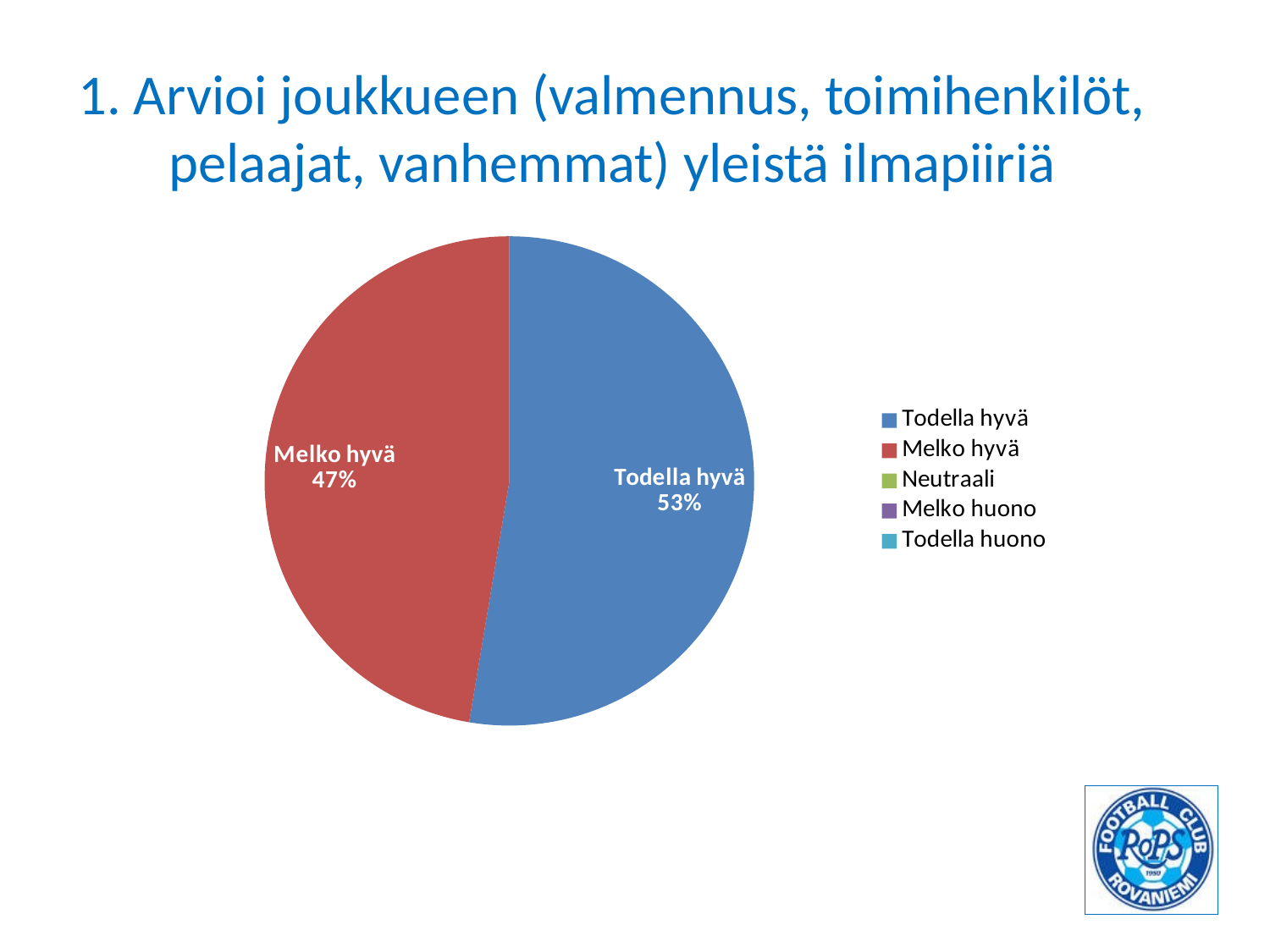
What is the difference in percentage points between the "Todella hyvä" and "Melko hyvä" slices? 6 What share of the pie does "Todella hyvä" have? 53% What share of the pie does "Melko hyvä" have? 47% Which slice of the pie is the largest? Todella hyvä Which legend entry is listed last? Todella huono How many slices are visible in the pie? 2 What colour is the "Melko hyvä" slice? red Which of the two visible slices is the smaller one? Melko hyvä How many entries does the legend list? 5 Which is larger, the "Todella hyvä" slice or the "Melko hyvä" slice? Todella hyvä Is the share for "Todella hyvä" greater or less than 50%? greater What kind of chart is shown on the slide? pie chart